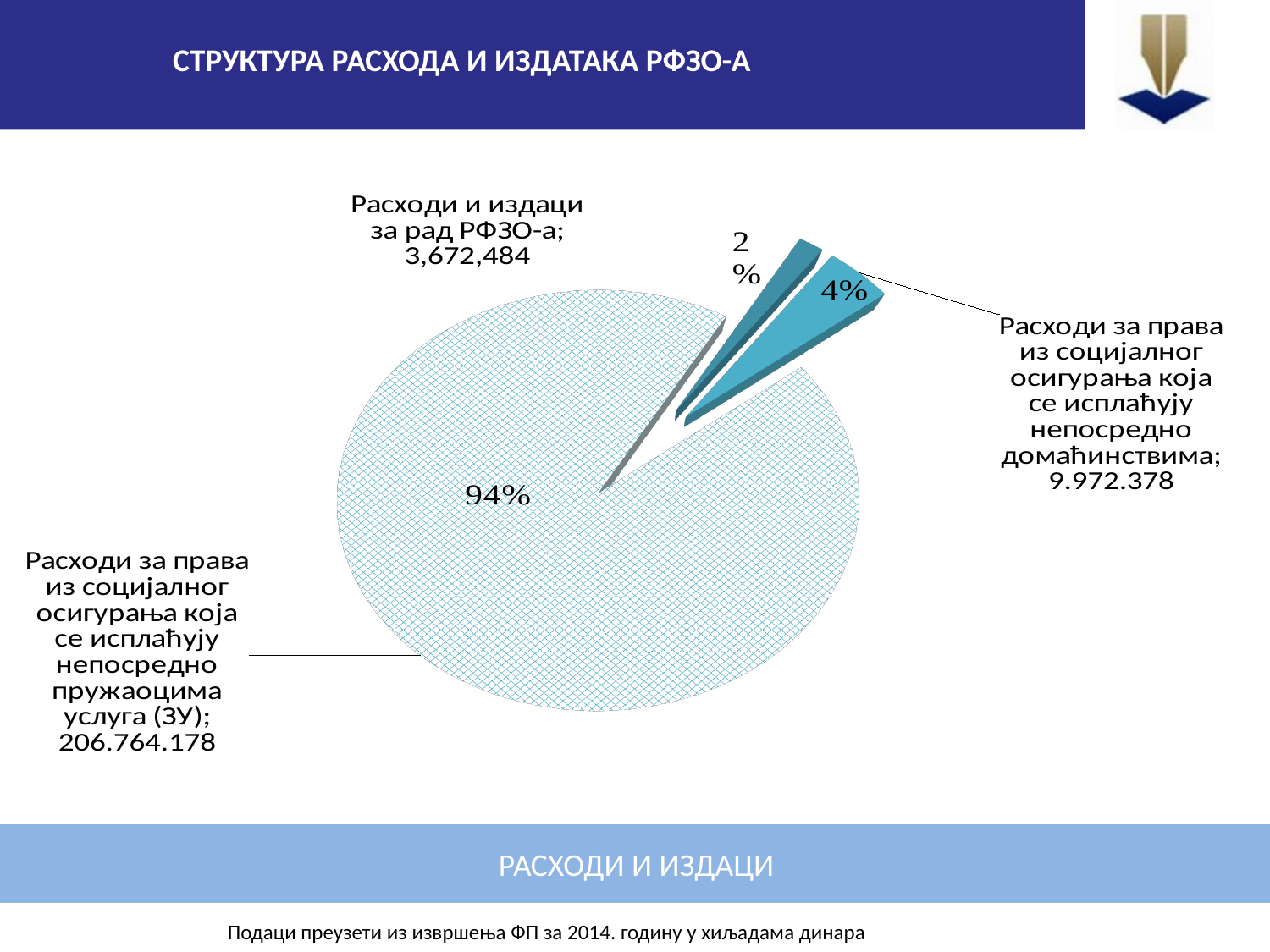
What is the title shown in the header of the slide? СТРУКТУРА РАСХОДА И ИЗДАТАКА РФЗО-А How many slices does the pie chart have? 3 Which category has the largest slice of the pie? Расходи за права из социјалног осигурања која се исплаћују непосредно пружаоцима услуга (ЗУ) What share of the pie is labelled for 'Расходи и издаци за рад РФЗО-а'? 2% Which category has the smallest slice of the pie? Расходи и издаци за рад РФЗО-а What value is printed for 'Расходи за права из социјалног осигурања која се исплаћују непосредно пружаоцима услуга (ЗУ)'? 206.764.178 What value is printed for 'Расходи и издаци за рад РФЗО-а'? 3,672,484 What share of the pie is labelled for 'Расходи за права из социјалног осигурања која се исплаћују непосредно пружаоцима услуга (ЗУ)'? 94% What value is printed for 'Расходи за права из социјалног осигурања која се исплаћују непосредно домаћинствима'? 9.972.378 What kind of chart is shown on the slide? pie chart Which is larger: the value for 'Расходи за права ... непосредно домаћинствима' or the value for 'Расходи и издаци за рад РФЗО-а'? Расходи за права ... непосредно домаћинствима What share of the pie is labelled for 'Расходи за права из социјалног осигурања која се исплаћују непосредно домаћинствима'? 4%